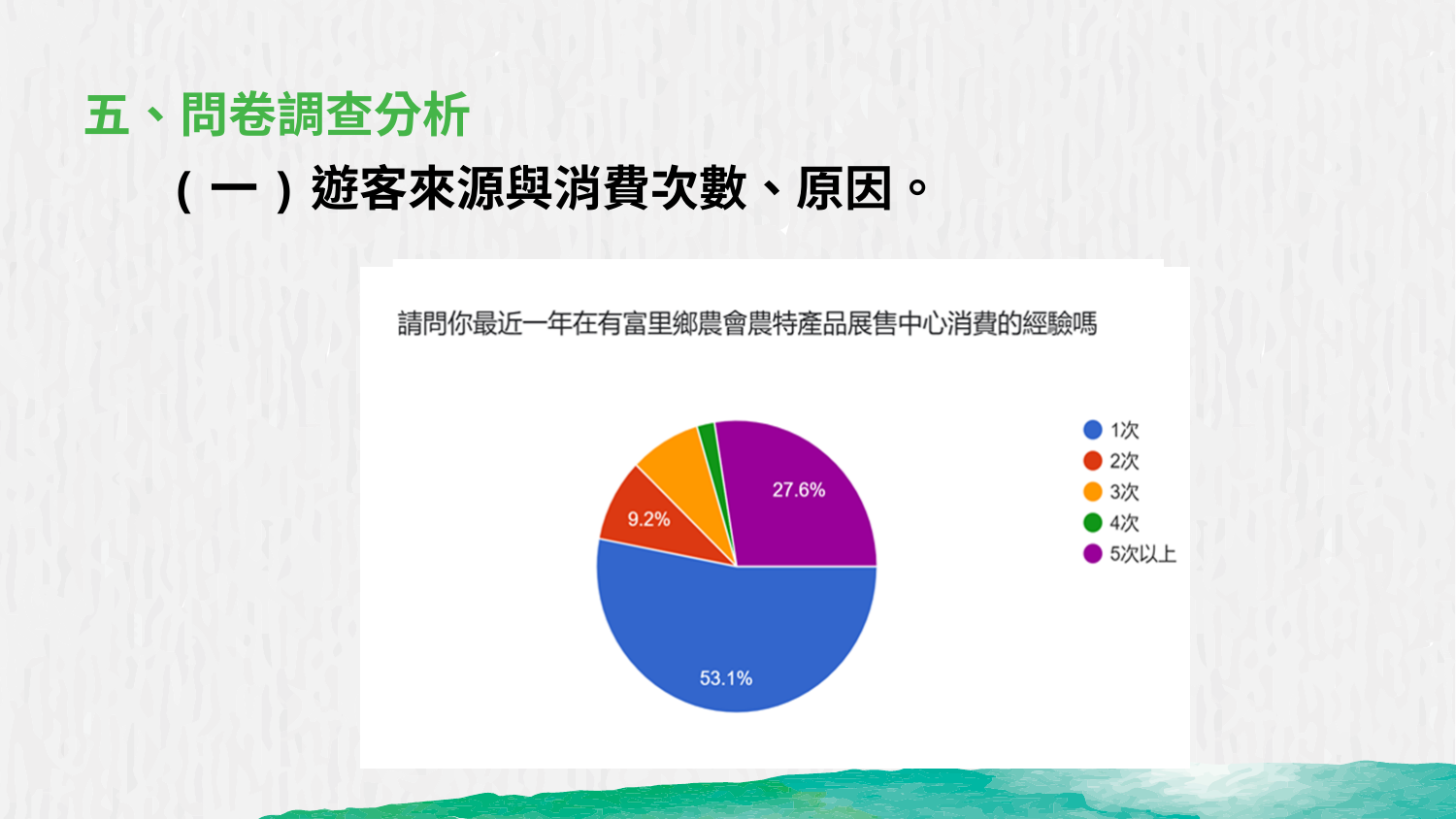
What share of the pie does the 1次 slice represent? 53.1% What colour is the 1次 slice in the pie chart? Blue What share of the pie does the 5次以上 slice represent? 27.6% What share of the pie does the 2次 slice represent? 9.2% What is the difference in percentage points between the 1次 slice and the 5次以上 slice? 25.5% What is the title of the chart? 請問你最近一年在有富里鄉農會農特產品展售中心消費的經驗嗎 Which slice is larger, 2次 or 5次以上? 5次以上 Which category has the largest slice of the pie? 1次 What is the difference in percentage points between the 5次以上 slice and the 2次 slice? 18.4% What kind of chart is shown on the slide? Pie chart How many categories are shown in the pie chart? 5 Which category has the smallest slice of the pie? 4次